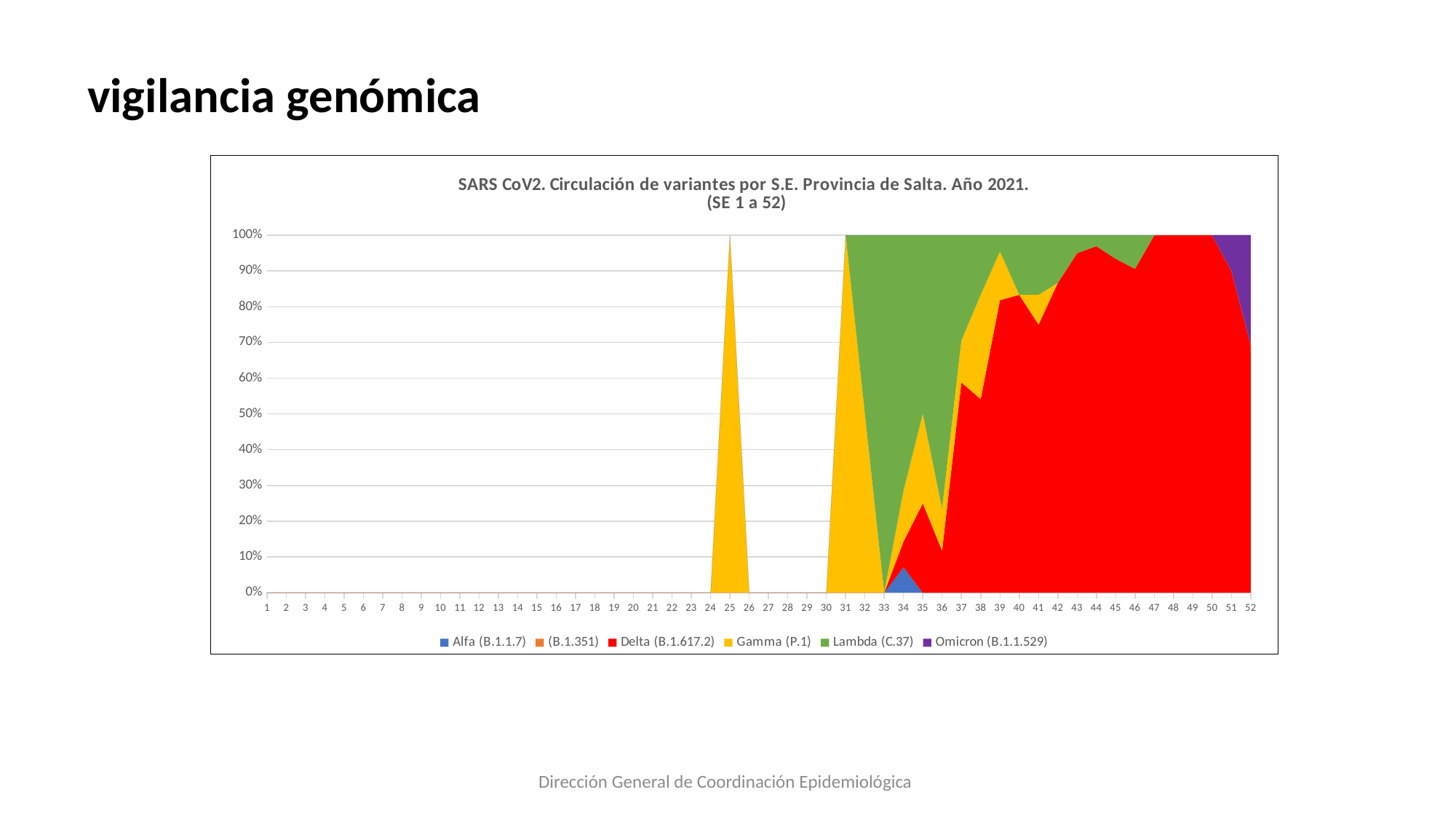
Is the share of Alfa (B.1.1.7) in week 34 greater or less than 10%? less What share does Delta (B.1.617.2) have in week 48? 100% How many epidemiological weeks (categories) are shown on the x axis? 52 Which variant has the largest share in week 52? Delta (B.1.617.2) Which variant is represented by the green area? Lambda (C.37) How many series does the legend list? 6 What share does Lambda (C.37) have in week 33? 100% What is the title of the chart? SARS CoV2. Circulación de variantes por S.E. Provincia de Salta. Año 2021. (SE 1 a 52) Is the share of Omicron (B.1.1.529) in week 52 greater or less than 40%? less What share does Gamma (P.1) have in week 25? 100% Does the share of Delta (B.1.617.2) rise or fall from week 36 to week 48? rise What kind of chart is shown on the slide? Stacked area chart